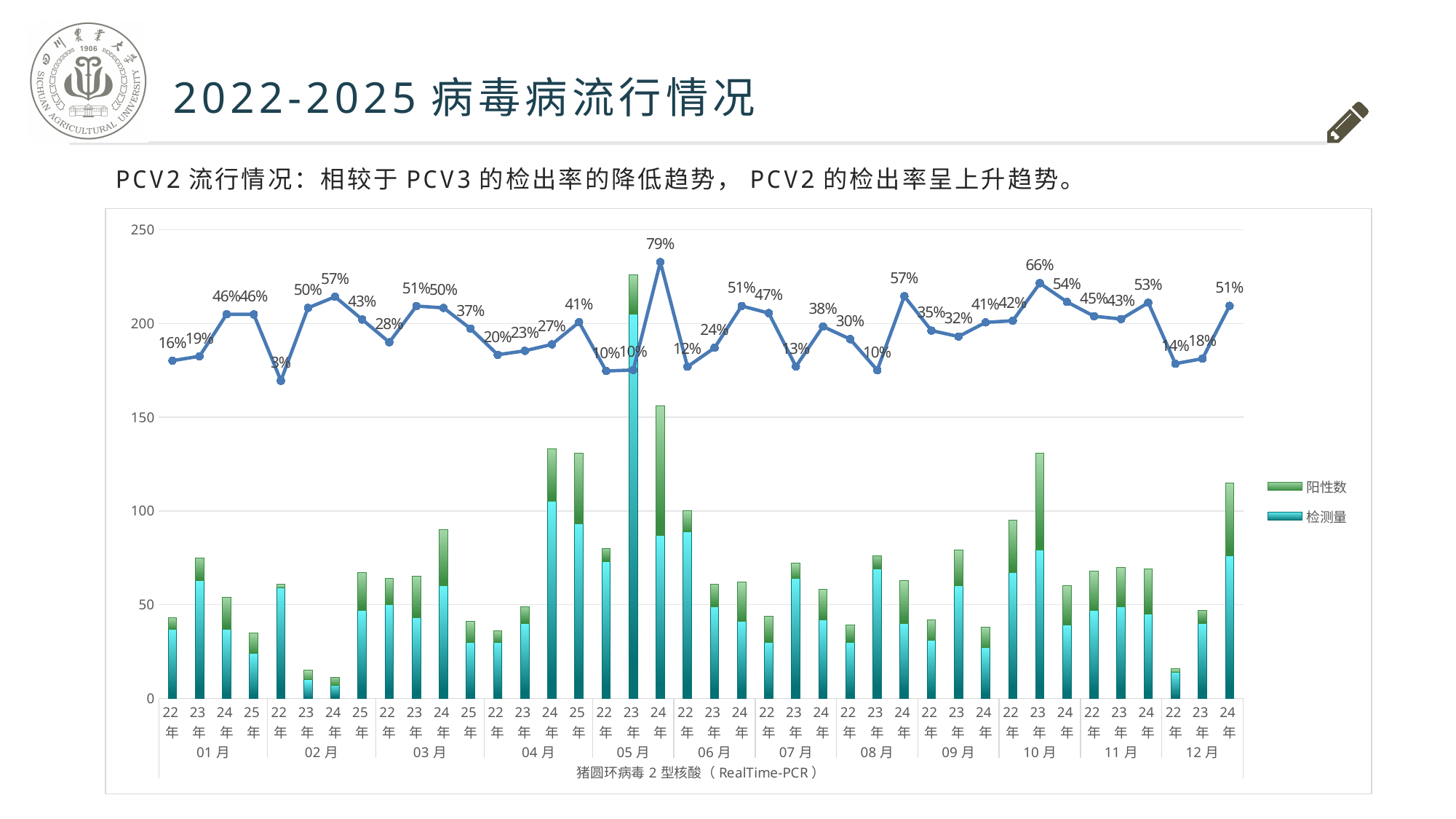
What is the difference between the percentage labels for 24年 in 05月 and 22年 in 05月? 69% What is the axis title shown below the month labels? 猪圆环病毒 2 型核酸（RealTime-PCR） How many series does the legend list? 2 What is the percentage label shown for 23年 in 10月? 66% Is the total height of the stacked bar for 23年 in 05月 greater or less than 200? greater What are the two entries in the chart legend? 阳性数 and 检测量 What is the percentage label shown for 22年 in 02月? 3% Which is larger, the percentage label for 23年 in 10月 or for 24年 in 10月? 23年 in 10月 (66%) Which month and year has the highest percentage label on the line? 05月 24年 (79%) Is the total height of the stacked bar for 23年 in 02月 greater or less than 50? less Which month and year has the lowest percentage label on the line? 02月 22年 (3%) What is the percentage label shown for 24年 in 05月? 79%